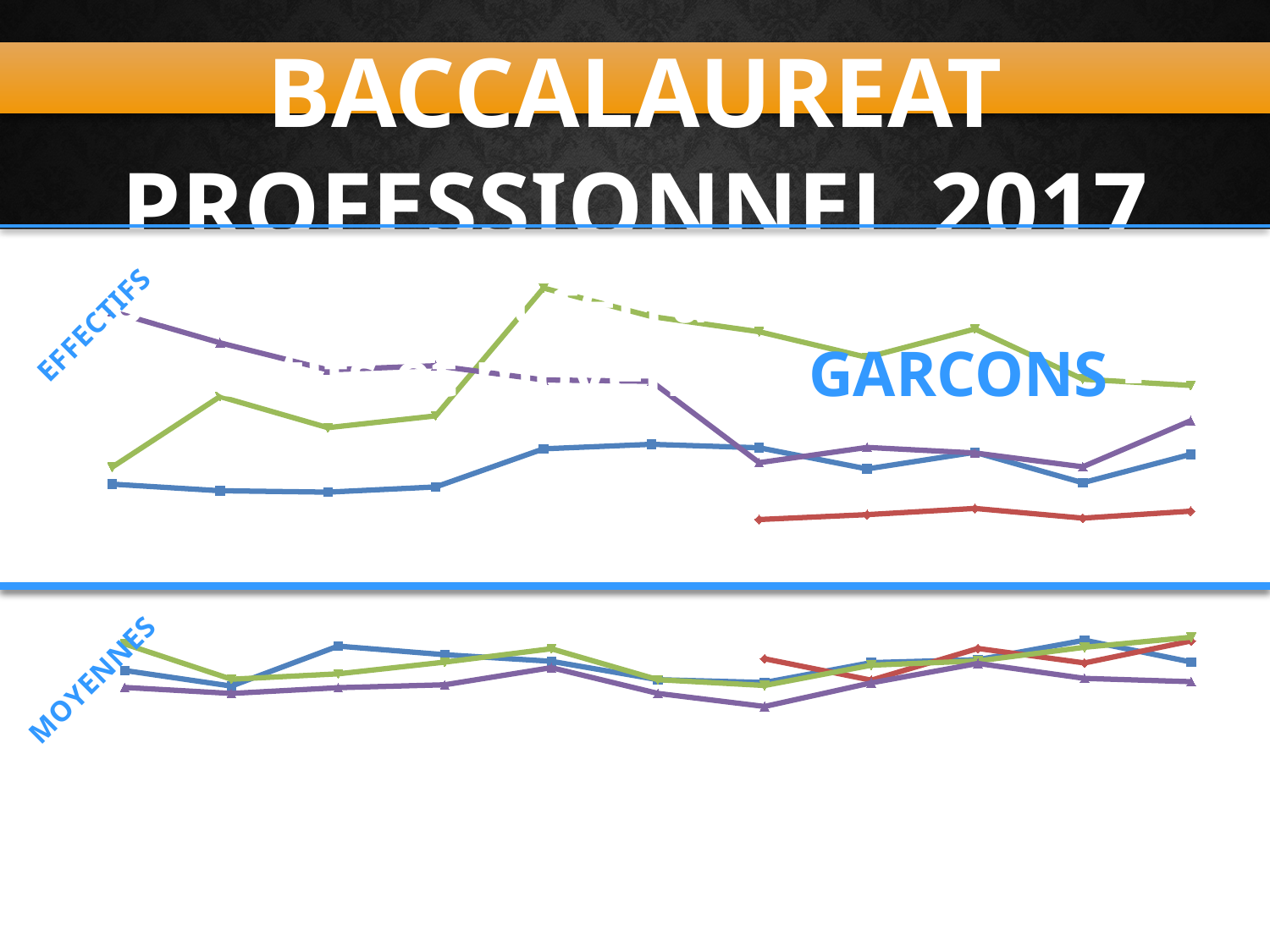
How many lines are plotted in the upper chart labelled EFFECTIFS? 4 In the upper chart labelled EFFECTIFS, which coloured line has the fewest plotted points? red What kind of chart is the upper chart labelled EFFECTIFS? line chart How many lines are plotted in the lower chart labelled MOYENNES? 4 In the upper chart labelled EFFECTIFS, does the purple line overall rise or fall from left to right? fall What word is written in large blue letters over the upper chart? GARCONS In the upper chart labelled EFFECTIFS, which coloured line is lowest at the rightmost point? red In the upper chart labelled EFFECTIFS, which coloured line is highest at the rightmost point? green What kind of chart is the lower chart labelled MOYENNES? line chart In the upper chart labelled EFFECTIFS, which coloured line is highest at the leftmost point? purple In the upper chart labelled EFFECTIFS, does the green line overall rise or fall from left to right? rise